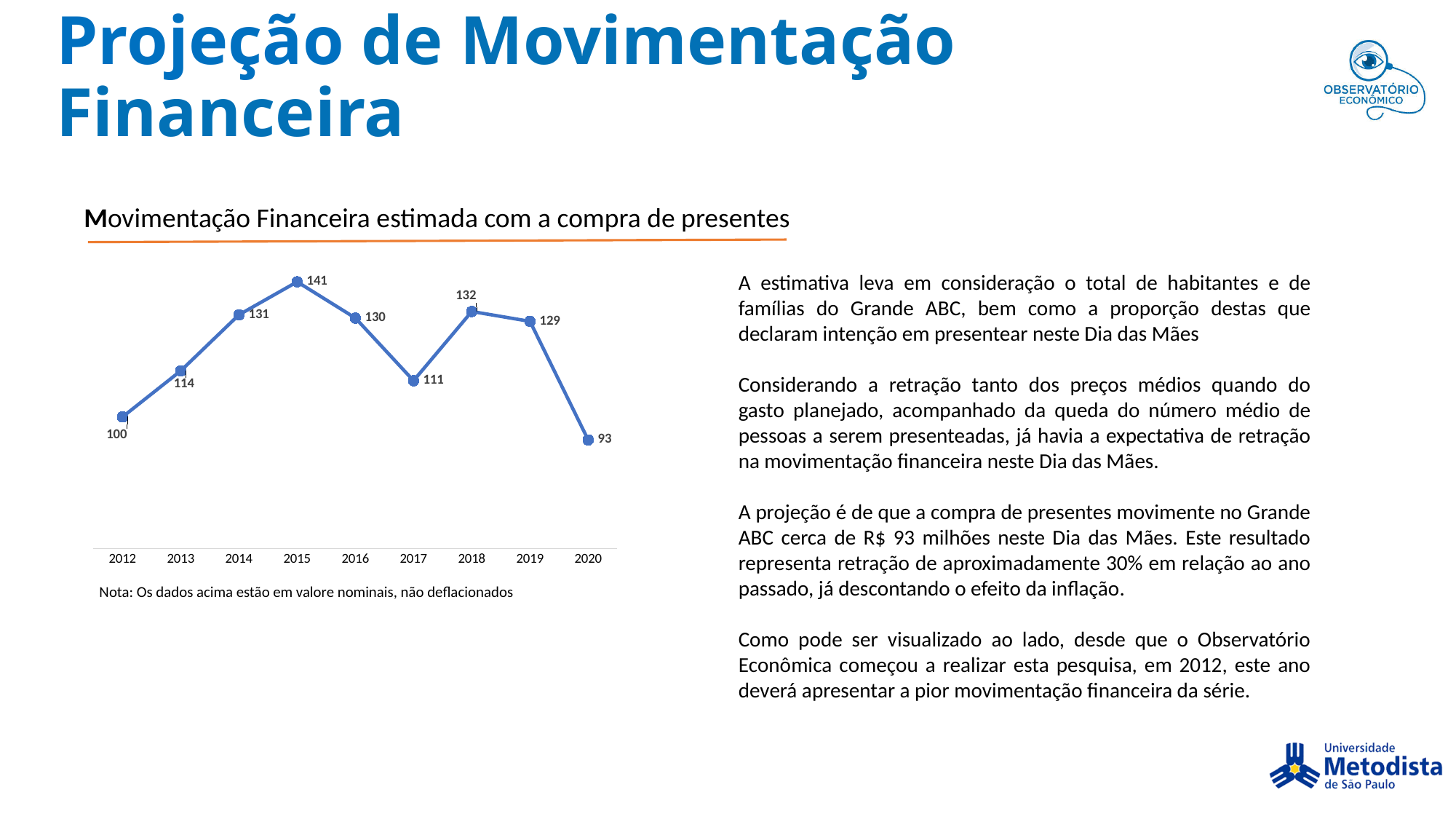
What is the difference between the values for 2015 and 2020? 48 Which year has the lowest value? 2020 Which year has the highest value? 2015 What is the difference between the values for 2018 and 2017? 21 What is the value for 2015? 141 What is the title of the chart? Movimentação Financeira estimada com a compra de presentes What is the value for 2017? 111 Which is larger, the value for 2014 or the value for 2016? 2014 Do the values rise or fall from 2018 to 2020? fall What kind of chart is shown on the slide? line chart What is the value for 2020? 93 How many years are plotted on the chart? 9